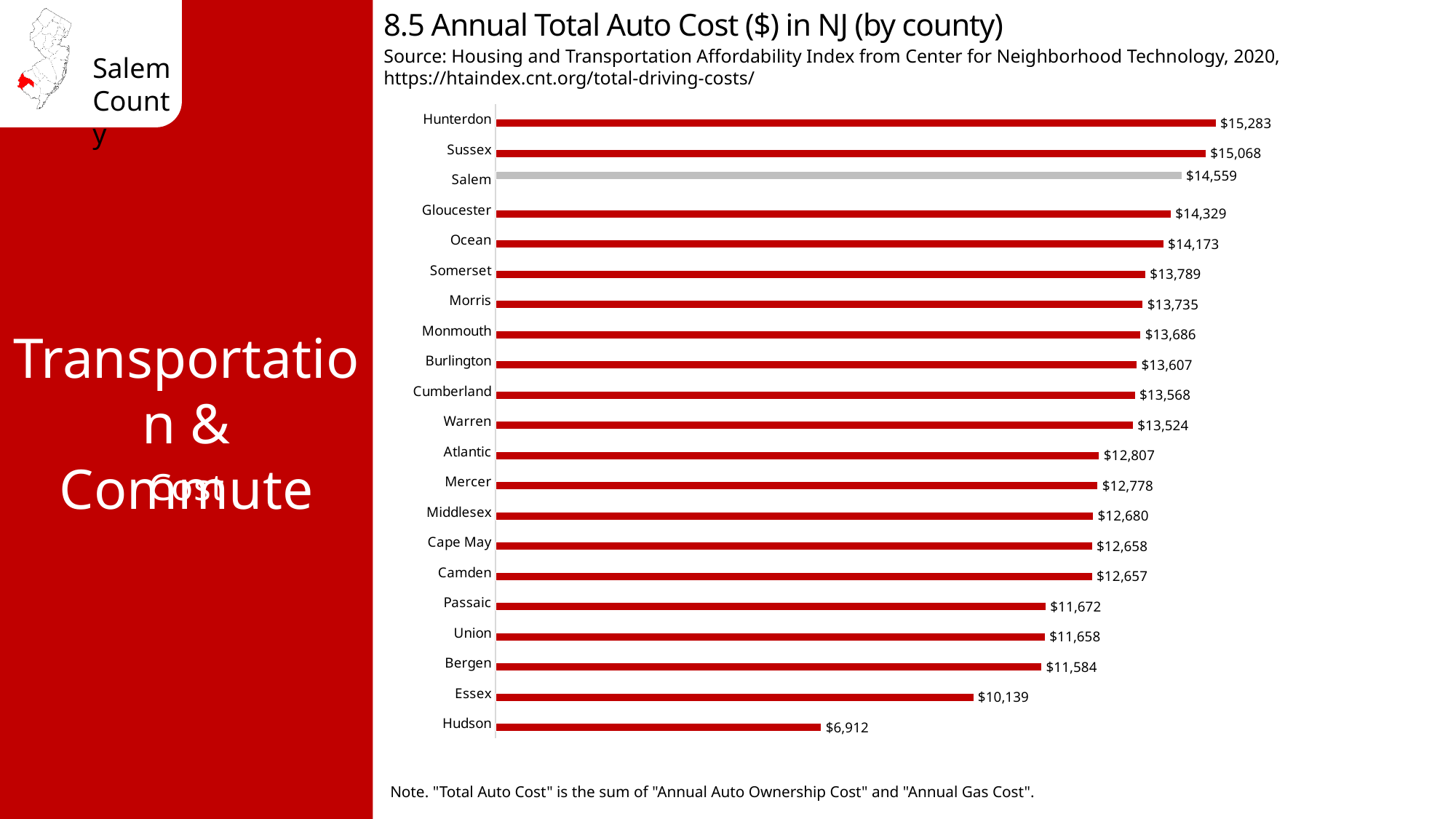
What is the annual total auto cost for Hudson County? $6,912 What is the difference in annual total auto cost between Essex and Hudson? $3,227 Which county has the lowest annual total auto cost? Hudson What type of chart is used on this slide? Bar chart What is the annual total auto cost for Gloucester County? $14,329 How many counties are shown in the chart? 21 What is the annual total auto cost for Salem County? $14,559 What is the difference in annual total auto cost between Hunterdon and Salem? $724 Which county's bar is shown in gray rather than red? Salem Which county has a higher annual total auto cost, Bergen or Essex? Bergen Which county has the highest annual total auto cost? Hunterdon Which county has a higher annual total auto cost, Sussex or Ocean? Sussex